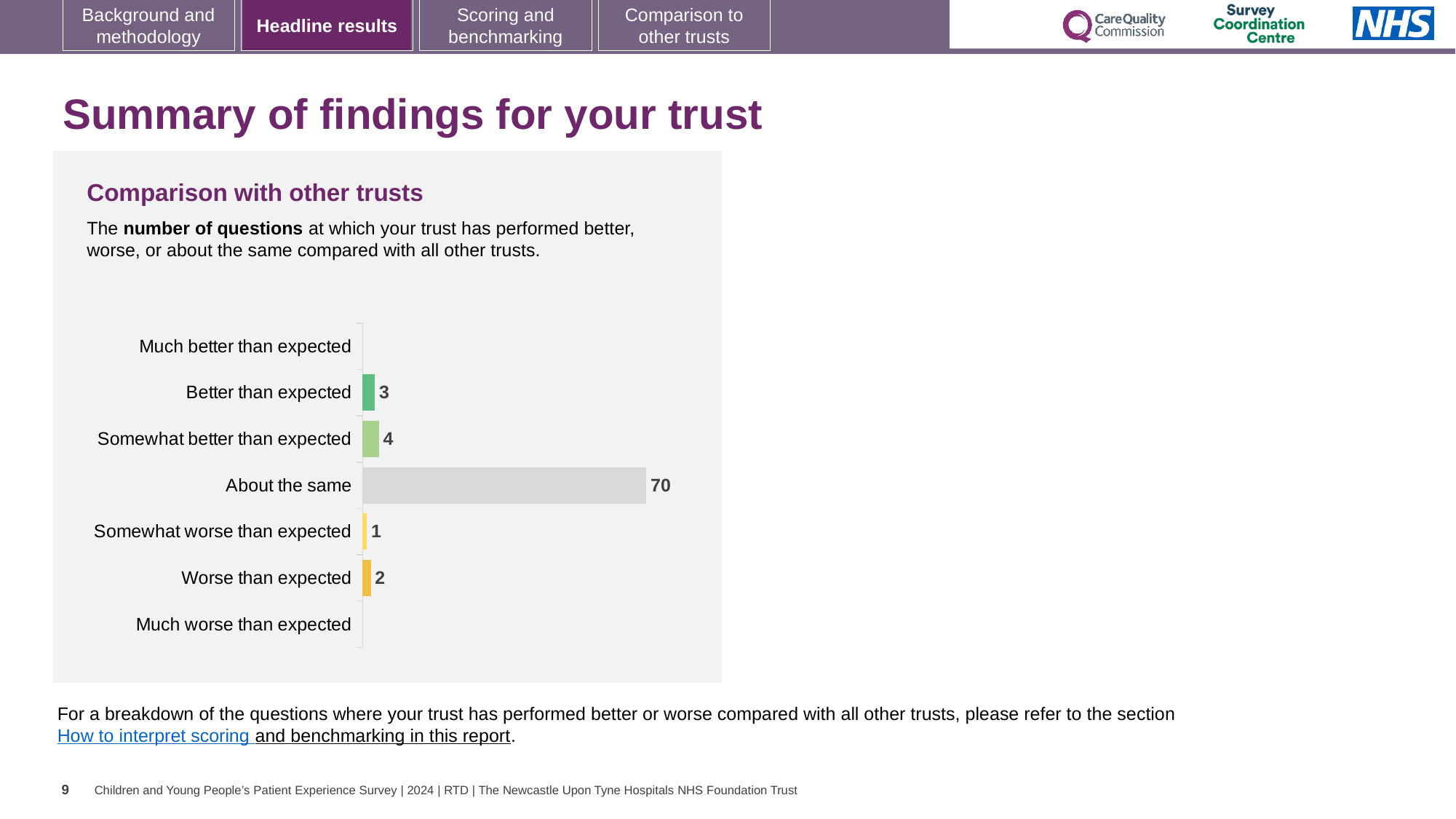
How many categories are listed on the chart's axis? 7 Which category has the highest number of questions? About the same What is the difference between the number of questions 'About the same' and 'Somewhat better than expected'? 66 What is the value for 'Better than expected'? 3 What is the value for 'Worse than expected'? 2 What is the value for 'Somewhat worse than expected'? 1 What kind of chart is shown on the slide? Bar chart How many questions are in the 'About the same' category? 70 Which is larger, 'Somewhat better than expected' or 'Better than expected'? Somewhat better than expected What is the title of the chart? Comparison with other trusts What is the difference between 'Worse than expected' and 'Somewhat worse than expected'? 1 What is the value for 'Somewhat better than expected'? 4